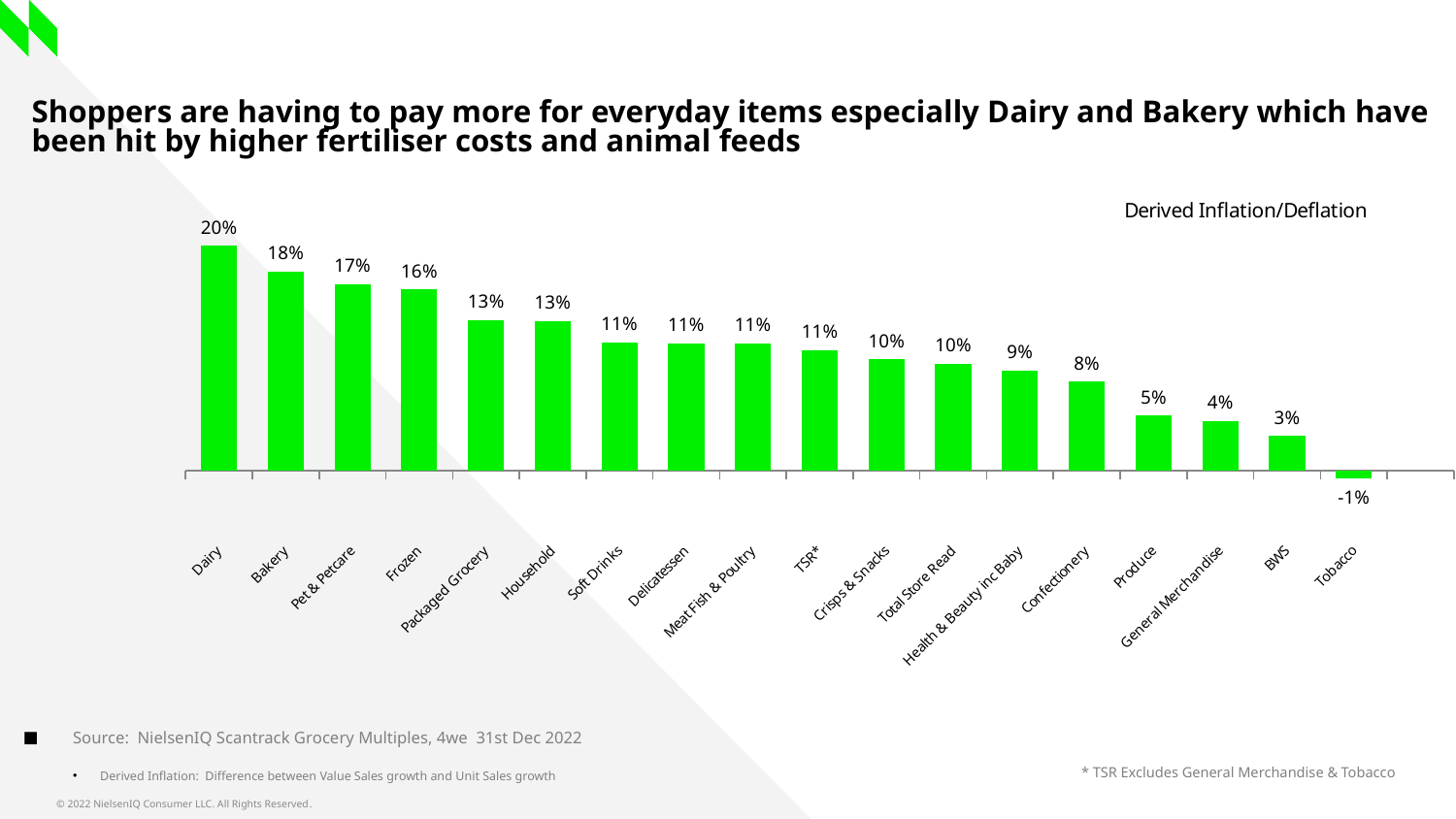
What is the value shown for Tobacco? -1% What is the difference between the values for Pet & Petcare and Produce? 12% What is the title of the chart? Derived Inflation/Deflation What is the value shown for Total Store Read? 10% Which category has the lowest value on the chart? Tobacco What type of chart is shown on the slide? Bar chart How many categories are shown on the chart? 18 Which is larger, the value for Confectionery or the value for BWS? Confectionery What is the derived inflation value for Dairy? 20% Which category has the highest derived inflation? Dairy What is the difference between the values for Dairy and Bakery? 2% What is the value shown for Frozen? 16%